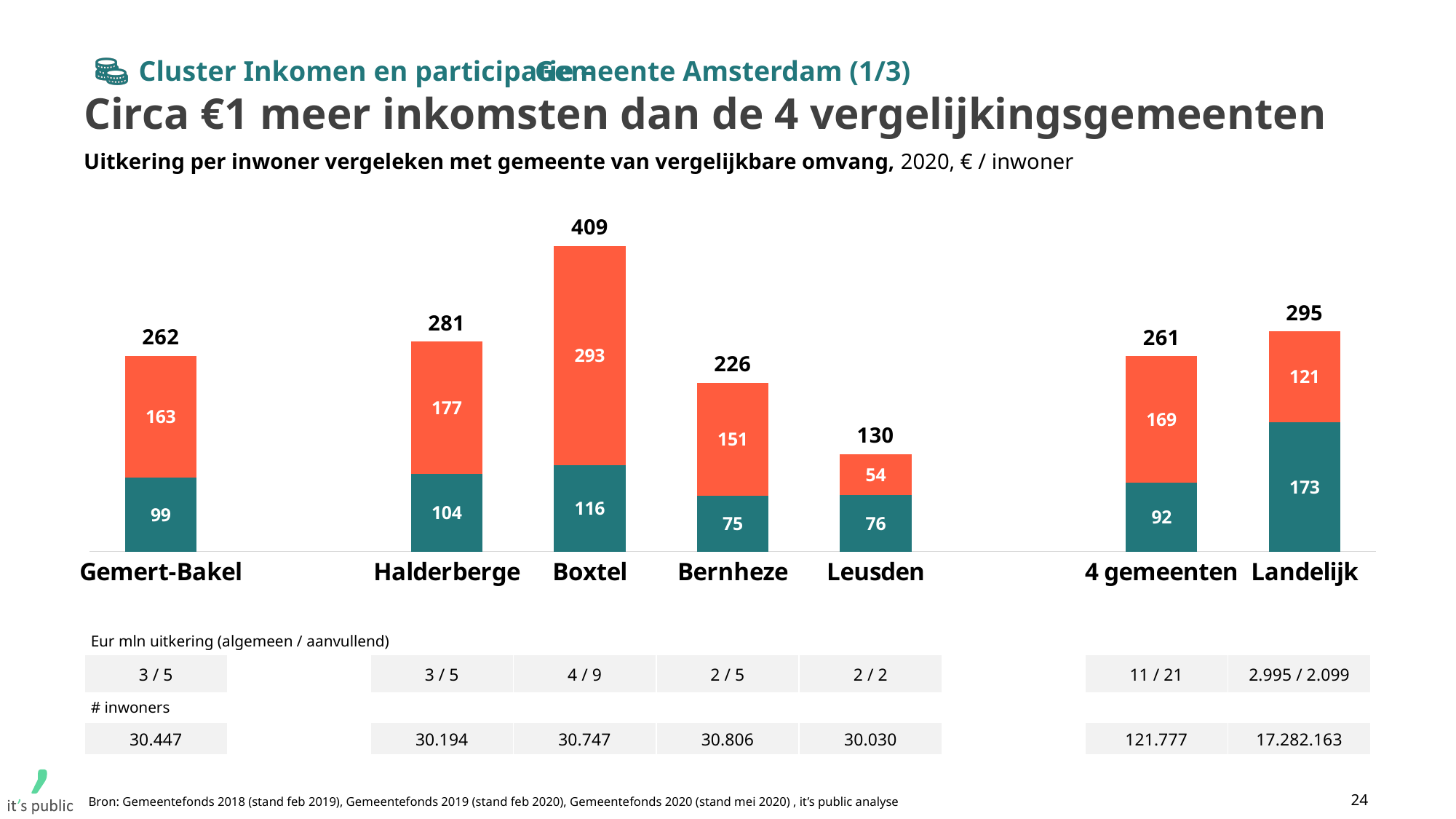
Which category has the highest total value? Boxtel What is the total value shown above the bar for Boxtel? 409 What is the total of the stacked bar for Leusden? 130 How many categories are shown on the x axis of the chart? 7 What is the value of the teal (bottom) segment for Gemert-Bakel? 99 What kind of chart is shown on the slide? Stacked bar chart What is the value of the orange (top) segment for Landelijk? 121 What is the difference between the total for Landelijk and the total for 4 gemeenten? 34 Which category has the lowest total value? Leusden What is the number of inhabitants (# inwoners) listed for Landelijk? 17.282.163 What is the value of the orange (top) segment for Boxtel? 293 Which has a larger total, Halderberge or Bernheze? Halderberge